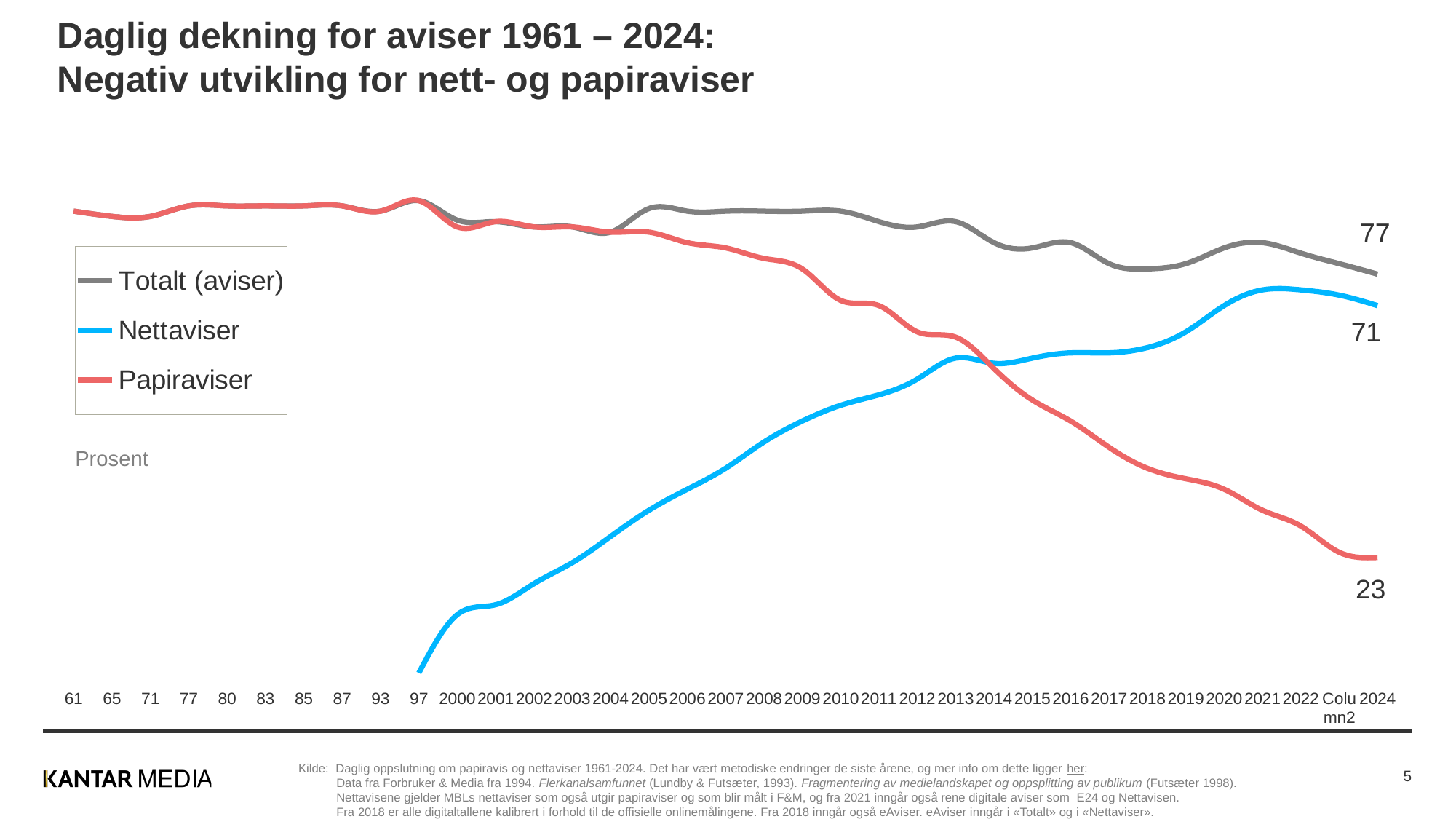
What is the difference between Totalt (aviser) and Nettaviser in 2024? 6 In 2024, which is larger: Nettaviser or Papiraviser? Nettaviser What is the value for Totalt (aviser) in 2024? 77 Which series has the lowest value in 2024? Papiraviser What is the difference between Nettaviser and Papiraviser in 2024? 48 Does the Nettaviser line rise or fall from 97 to 2013? Rises What is the value for Nettaviser in 2024? 71 What kind of chart is shown on the slide? Line chart What is the value for Papiraviser in 2024? 23 How many series does the legend list? 3 Does the Papiraviser line rise or fall from 2010 to 2024? Falls Which series has the highest value in 2024? Totalt (aviser)